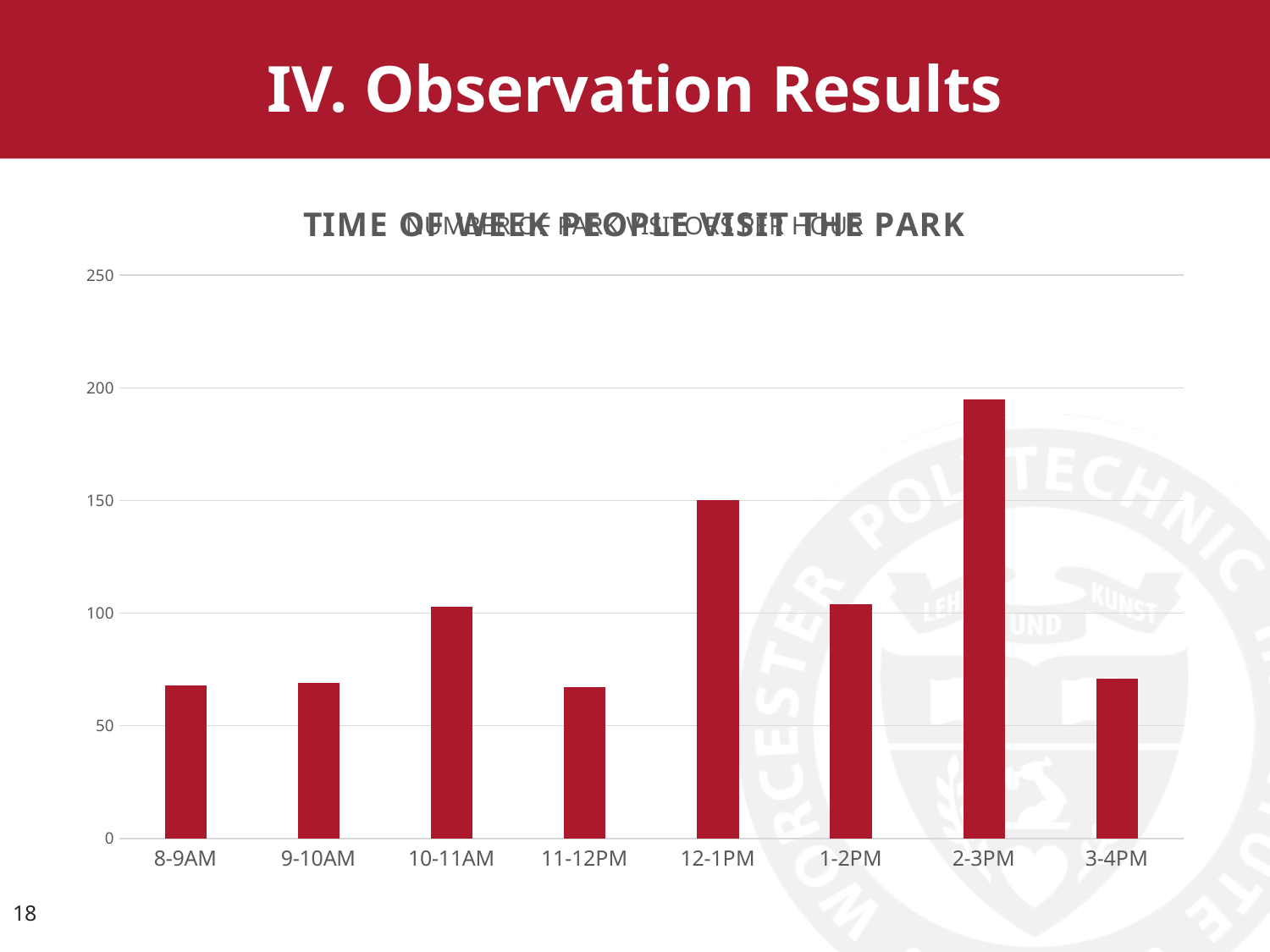
Is the value for 2-3PM greater or less than 150? greater Is the value for 12-1PM greater or less than 100? greater Is the value for 10-11AM greater or less than 150? less Which is larger, the value for 12-1PM or the value for 1-2PM? 12-1PM How many time-slot categories are shown on the x axis? 8 What colour are the bars in the chart? dark red What kind of chart is shown on the slide? bar chart Which is larger, the value for 10-11AM or the value for 11-12PM? 10-11AM Which is larger, the value for 2-3PM or the value for 3-4PM? 2-3PM Which time slot has the highest number of visitors? 2-3PM